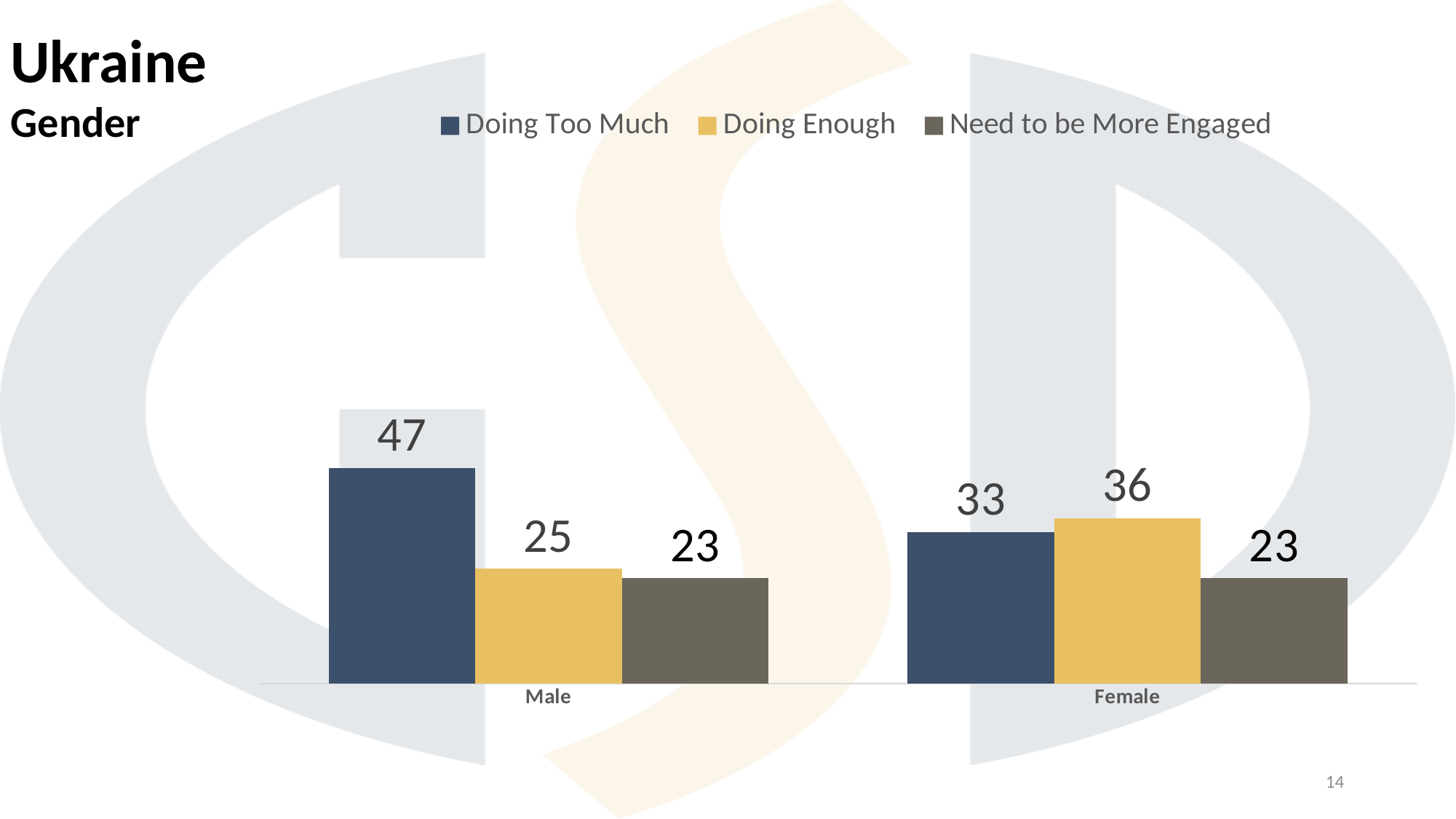
What is the difference between Doing Enough for Female and Doing Enough for Male? 11 Which series has the highest value for Male? Doing Too Much How many series does the legend list? 3 What kind of chart is shown on the slide? Bar chart What is the difference between the Doing Too Much values for Male and Female? 14 What is the value for Need to be More Engaged among Male respondents? 23 What is the value for Doing Too Much among Male respondents? 47 Which series has the lowest value for Female? Need to be More Engaged What is the value for Doing Too Much among Female respondents? 33 How many categories are shown on the x axis? 2 What is the value for Doing Enough among Female respondents? 36 Which is larger: Doing Enough for Male or Doing Enough for Female? Female